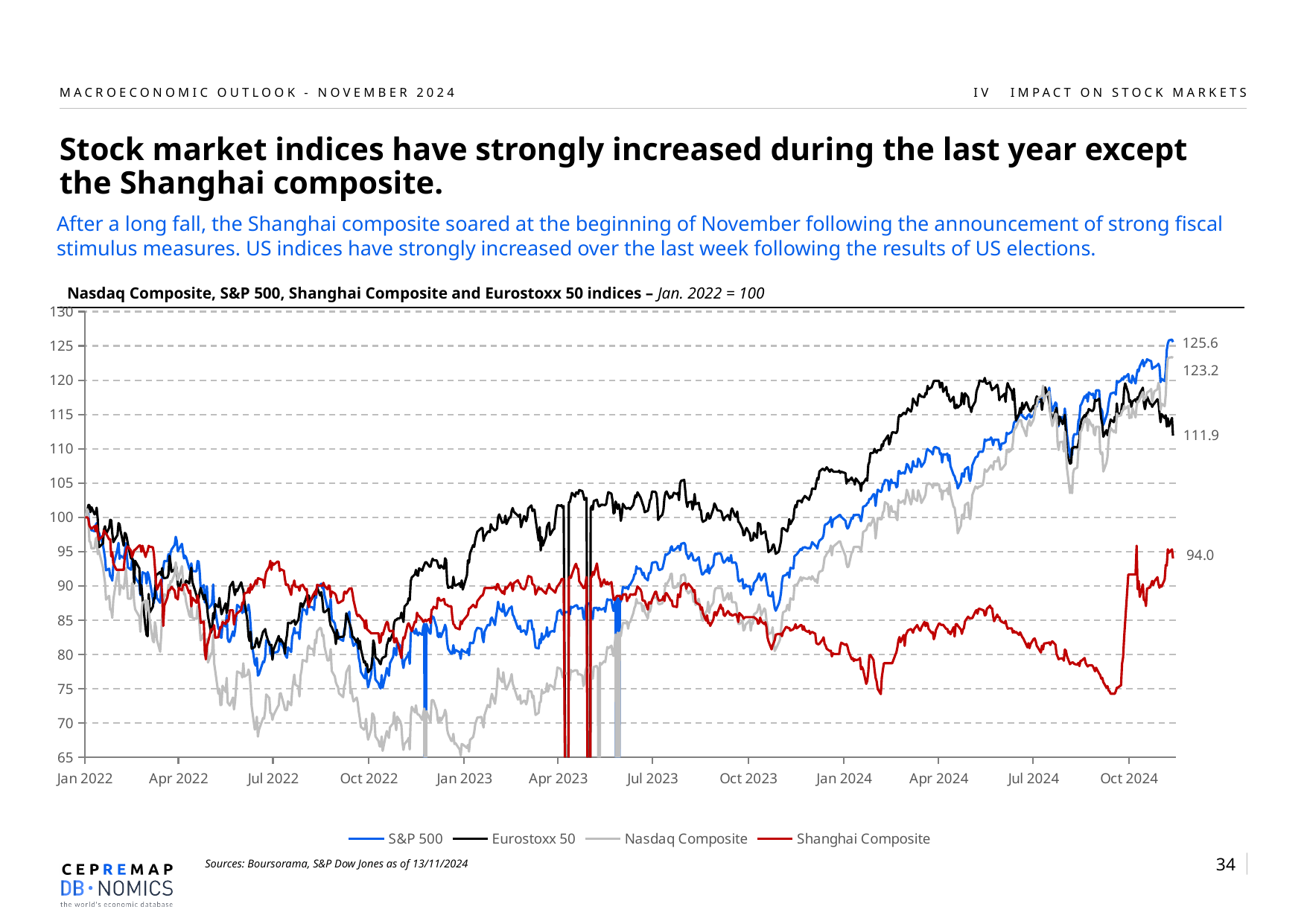
What is the final value shown for the S&P 500 at the right end of the chart? 125.6 What is the final value shown for the Nasdaq Composite at the right end of the chart? 123.2 Does the Shanghai Composite overall rise or fall from Jan 2022 to Oct 2024? fall Which index has the lowest value at the right end of the chart? Shanghai Composite Which index has the highest value at the right end of the chart? S&P 500 What kind of chart is shown on the slide? Line chart What is the final value shown for the Shanghai Composite at the right end of the chart? 94.0 What base period is the chart indexed to, according to the chart title? Jan. 2022 = 100 At the right end of the chart, which is larger: the Nasdaq Composite or the Eurostoxx 50? Nasdaq Composite How many series does the legend list? 4 What is the difference between the final values of the S&P 500 (125.6) and the Shanghai Composite (94.0)? 31.6